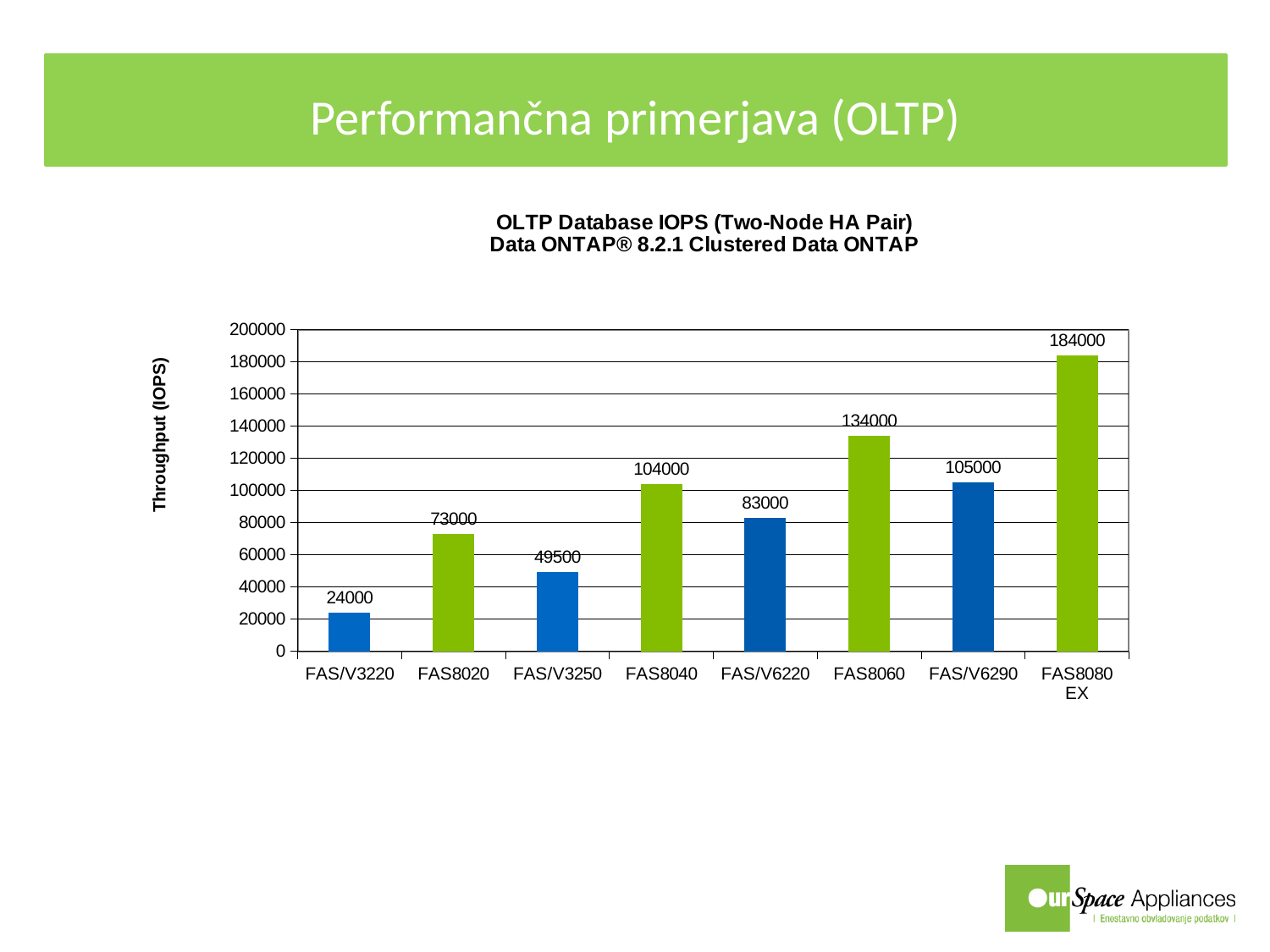
What is the label of the vertical axis? Throughput (IOPS) Is the throughput for FAS8060 greater or less than 120000? greater What is the throughput (IOPS) for FAS8040? 104000 What kind of chart is shown on the slide? bar chart What is the difference in throughput between FAS8080 EX and FAS8060? 50000 What is the throughput (IOPS) for FAS/V6290? 105000 How many systems are shown on the x axis? 8 Which system has the lowest throughput? FAS/V3220 Which system has the highest throughput? FAS8080 EX Which has higher throughput, FAS/V6220 or FAS8040? FAS8040 What is the throughput (IOPS) for FAS/V3220? 24000 What is the difference in throughput between FAS8020 and FAS/V3250? 23500